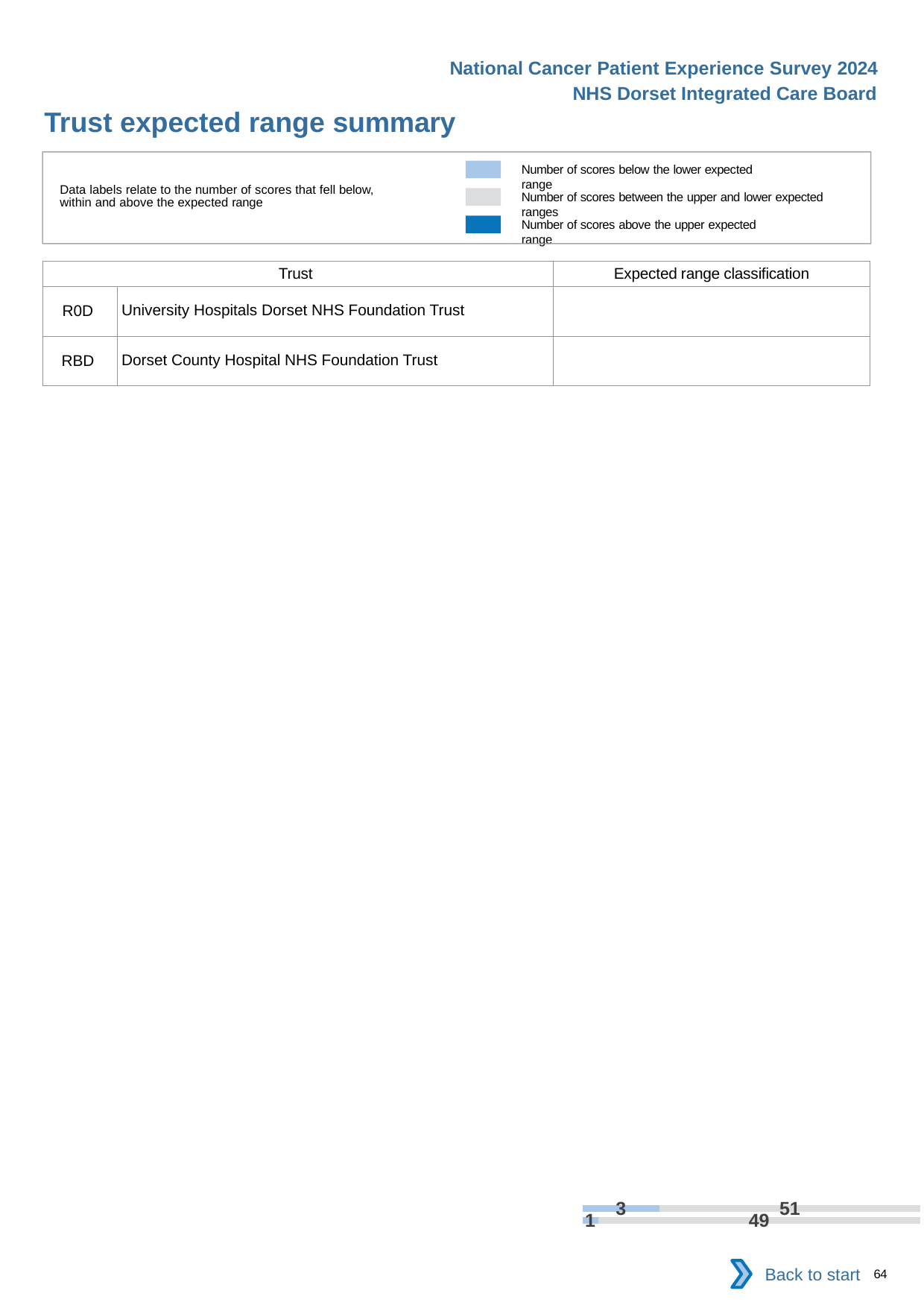
Which bar has the larger light blue segment (scores below the lower expected range), the top bar or the bottom bar? top bar How many bars are plotted in the chart at the bottom of the slide? 2 In the bottom bar of the chart, what is the value of the light blue segment (number of scores below the lower expected range)? 1 What is the difference between the grey segment values of the top bar and the bottom bar? 2 Which colour in the legend represents the number of scores above the upper expected range? dark blue How many entries does the legend list for the chart? 3 What kind of chart is shown at the bottom of the slide? bar chart In the bottom bar of the chart, what is the value of the grey segment (number of scores between the upper and lower expected ranges)? 49 In the top bar of the chart, what is the value of the grey segment (number of scores between the upper and lower expected ranges)? 51 In the top bar of the chart, what is the value of the light blue segment (number of scores below the lower expected range)? 3